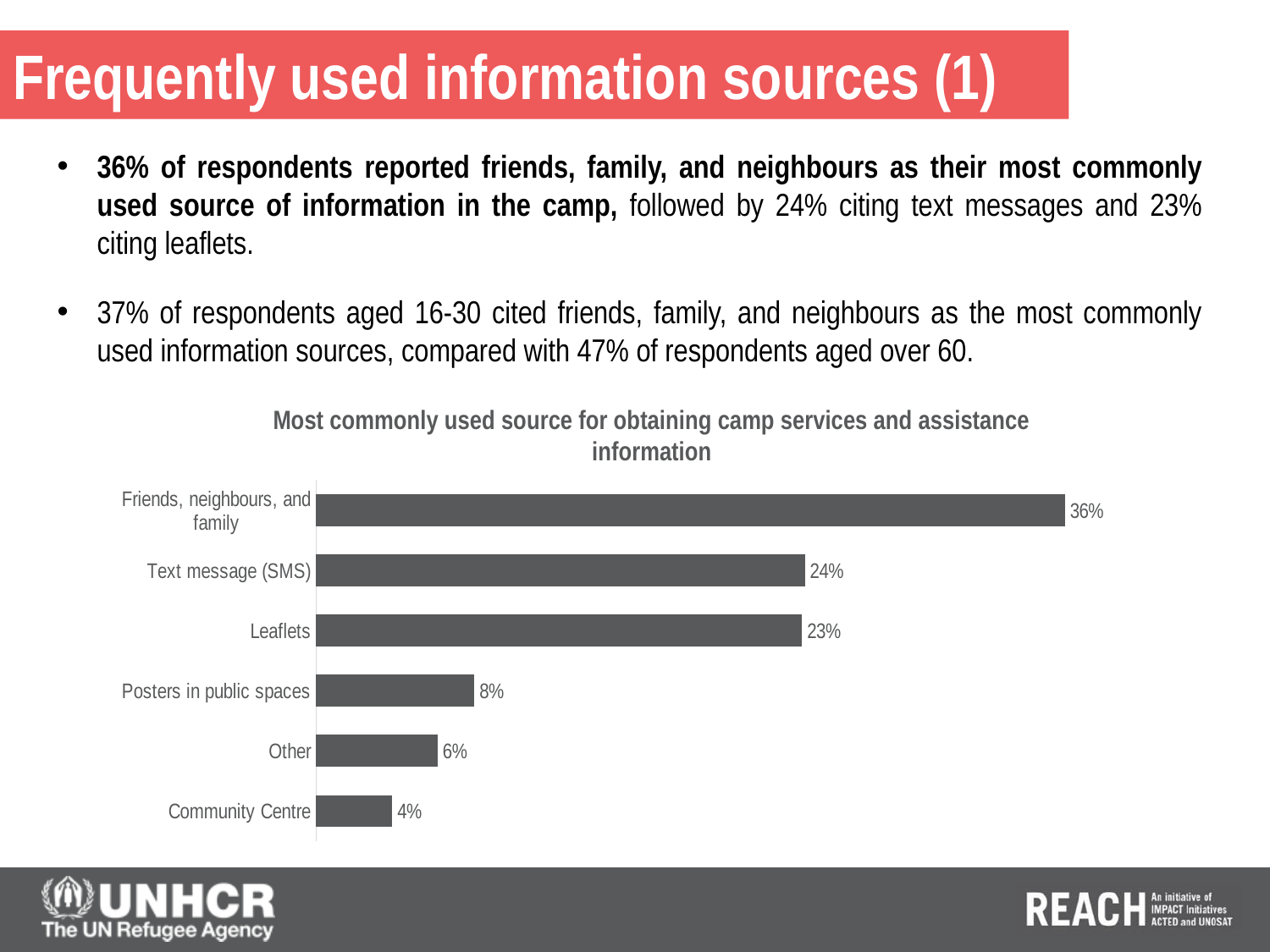
What is the value shown for Community Centre? 4% Which has a larger value, Text message (SMS) or Leaflets? Text message (SMS) What type of chart is shown on the slide? Bar chart What is the value shown for Posters in public spaces? 8% What is the difference between the values for Posters in public spaces and Other? 2% What is the difference between the values for Friends, neighbours, and family and Leaflets? 13% Which category has the highest value in the chart? Friends, neighbours, and family How many categories are shown in the chart? 6 What percentage of respondents cited Text message (SMS) as their most commonly used source? 24% What is the title of the chart? Most commonly used source for obtaining camp services and assistance information Which category has the lowest value in the chart? Community Centre Which has a larger value, Other or Community Centre? Other